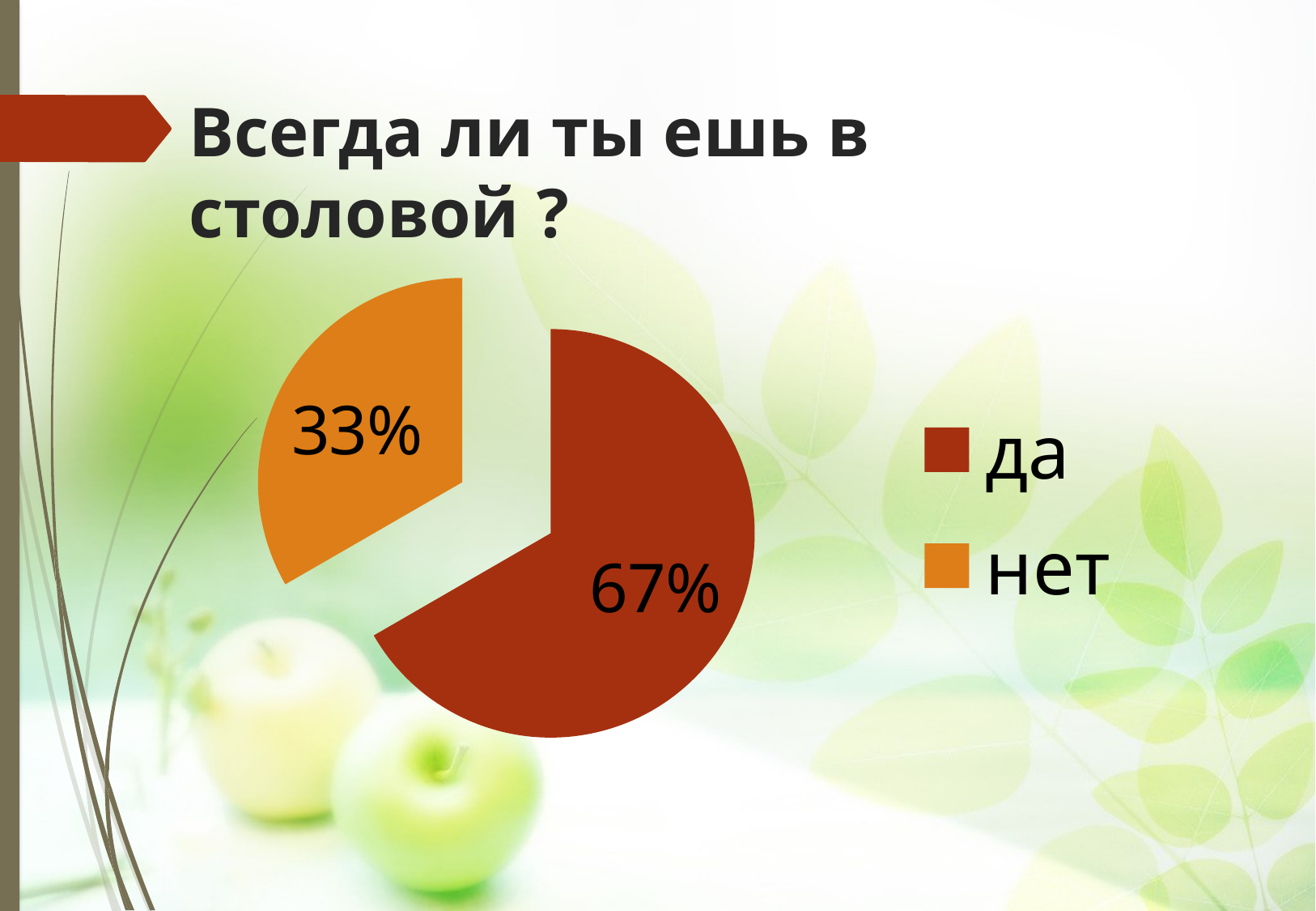
What colour is the "нет" slice in the pie chart? orange Which category has the smallest share of the pie chart? нет Which slice is larger, "да" or "нет"? да What type of chart is shown on the slide? pie chart What is the difference in percentage points between the "да" and "нет" slices? 34 Which category has the largest share of the pie chart? да What is the title of the slide above the chart? Всегда ли ты ешь в столовой ? How many entries does the legend list? 2 What percentage of the pie chart corresponds to "да"? 67% How many slices does the pie chart have? 2 What percentage of the pie chart corresponds to "нет"? 33% What share of the pie does the "нет" slice represent? 33%